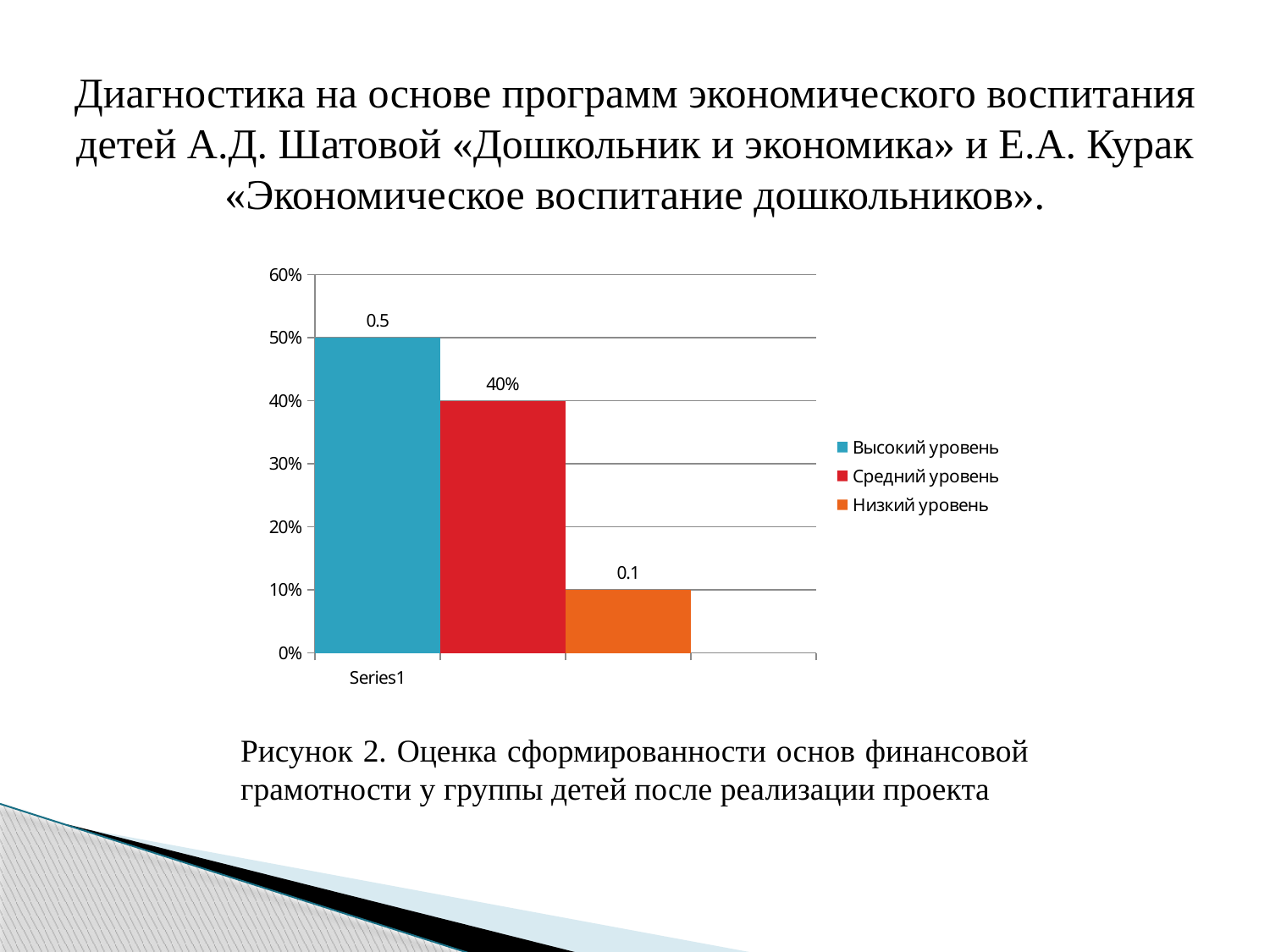
What value is shown for Высокий уровень? 0.5 What is the difference between the values for Высокий уровень and Низкий уровень? 0.4 Which is larger, the value for Средний уровень or the value for Низкий уровень? Средний уровень What value is shown for Низкий уровень? 0.1 Which series has the highest value? Высокий уровень Which series has the lowest value? Низкий уровень Is the value for Средний уровень greater or less than 30%? greater What kind of chart is shown on the slide? bar chart How many series does the legend list? 3 What is the category label shown on the x axis? Series1 What colour is the bar for Низкий уровень? orange What value is shown for Средний уровень? 40%